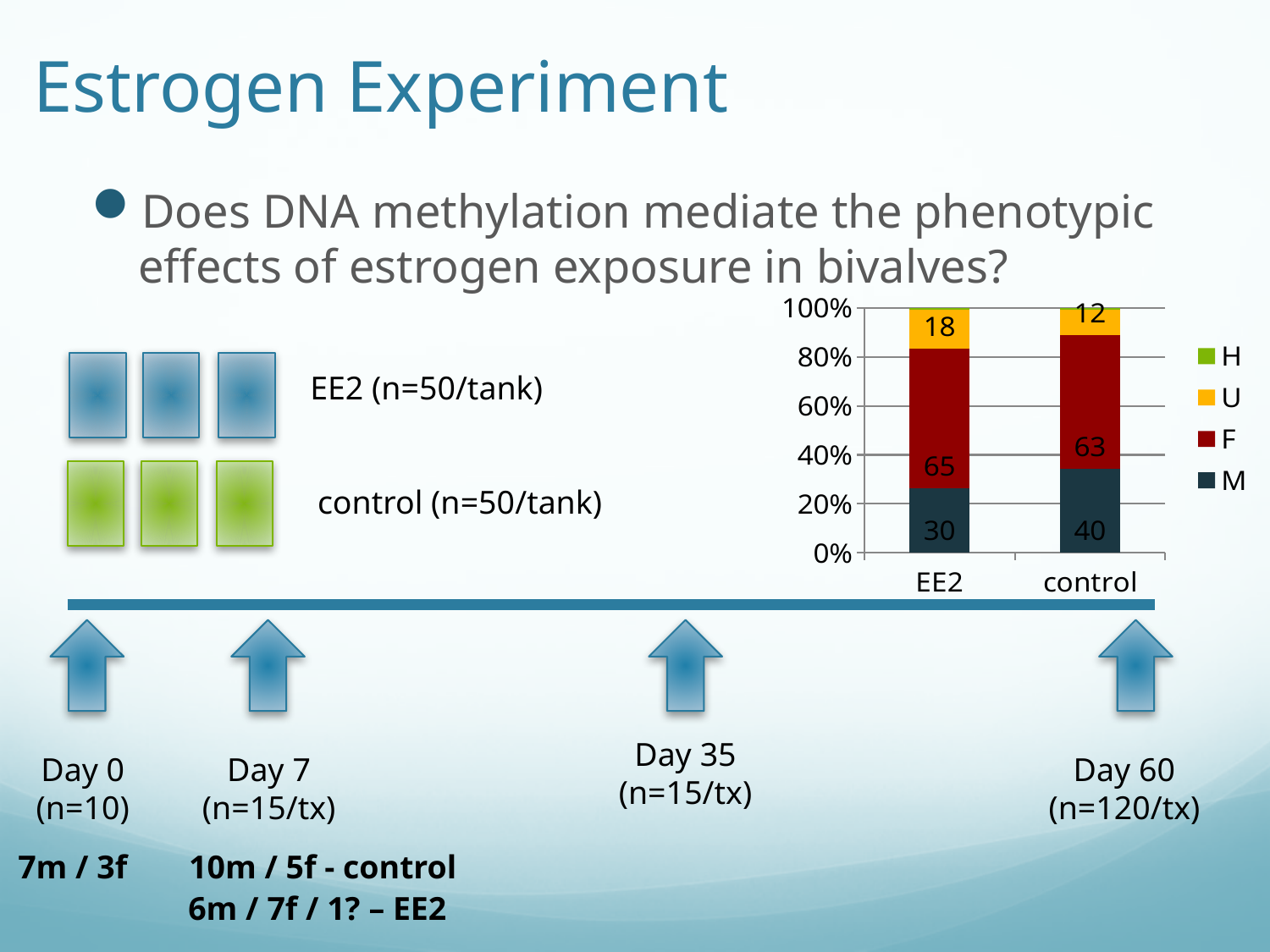
What is the value of the M segment for EE2? 30 What kind of chart is shown on the slide? stacked bar chart What is the value of the U segment for control? 12 What is the value of the M segment for control? 40 What is the value of the U segment for EE2? 18 Which series has the largest value in the EE2 bar? F What is the difference between the F values for EE2 and control? 2 What is the value of the F segment for control? 63 How many series does the chart legend list? 4 What is the difference between the U values for EE2 and control? 6 How many categories are shown on the x axis of the chart? 2 Which has the larger M value, EE2 or control? control